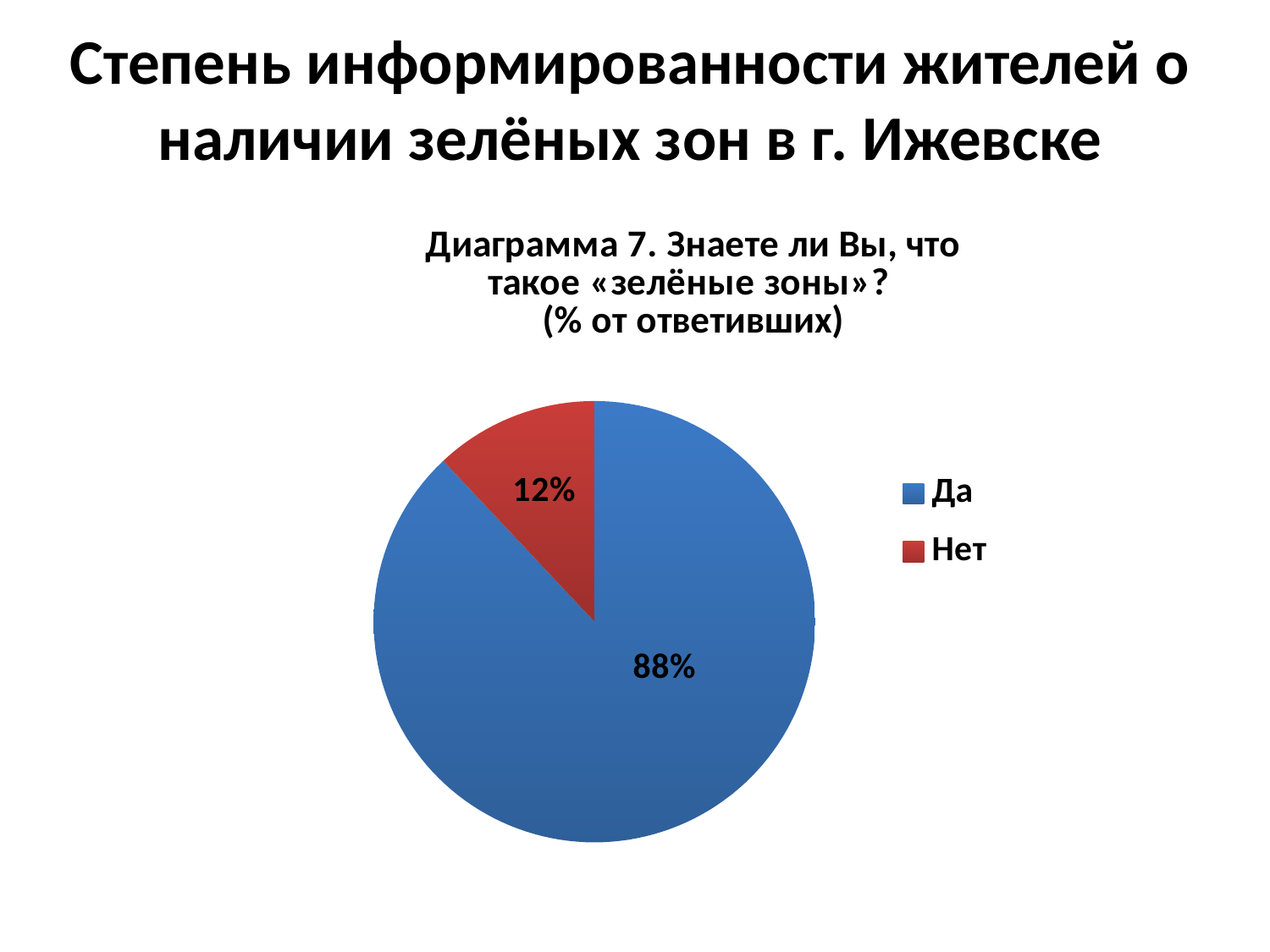
How many entries does the legend list? 2 Which answer has the smallest slice of the pie? Нет How many slices does the pie chart have? 2 What is the total of the two slices shown in the pie chart? 100% What share of respondents answered "Нет"? 12% What share of respondents answered "Да"? 88% What is the difference in percentage points between the "Да" and "Нет" slices? 76 Which answer has the largest slice of the pie? Да What type of chart is shown on the slide? pie chart Which slice is larger, "Да" or "Нет"? Да What is the title of the chart? Диаграмма 7. Знаете ли Вы, что такое «зелёные зоны»? (% от ответивших) What colour is the "Нет" slice? red